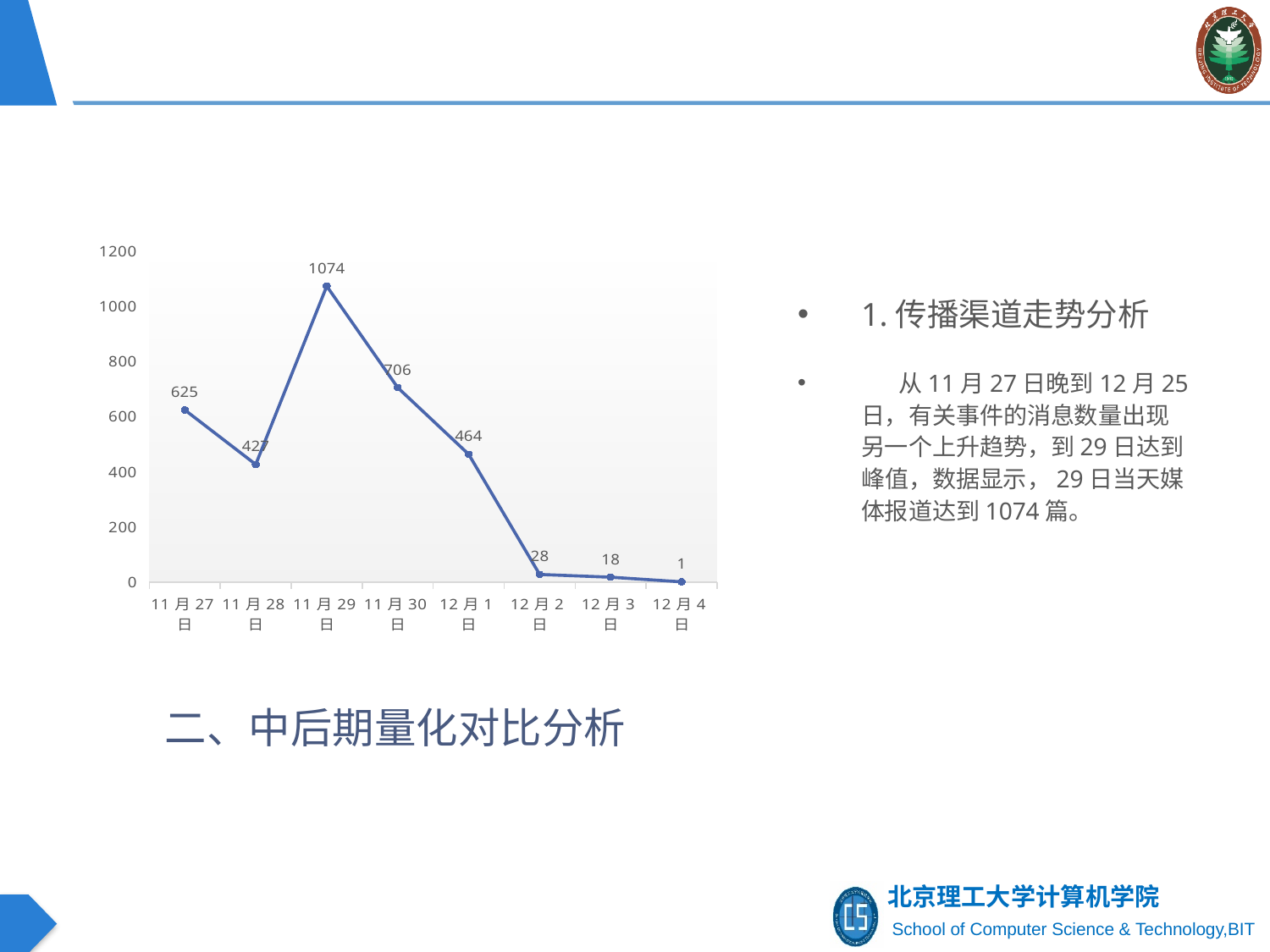
What is the value for 12月4日? 1 How many dates are plotted on the x axis? 8 What is the value for 11月29日? 1074 What kind of chart is shown on the slide? line chart What is the value for 12月1日? 464 Which is larger, the value for 11月27日 or the value for 11月28日? 11月27日 What is the value for 11月27日? 625 What is the difference between the values for 11月29日 and 11月30日? 368 Is the value for 11月30日 greater or less than 600? greater Which date has the highest value? 11月29日 Do the values rise or fall from 12月1日 to 12月4日? fall Which date has the lowest value? 12月4日